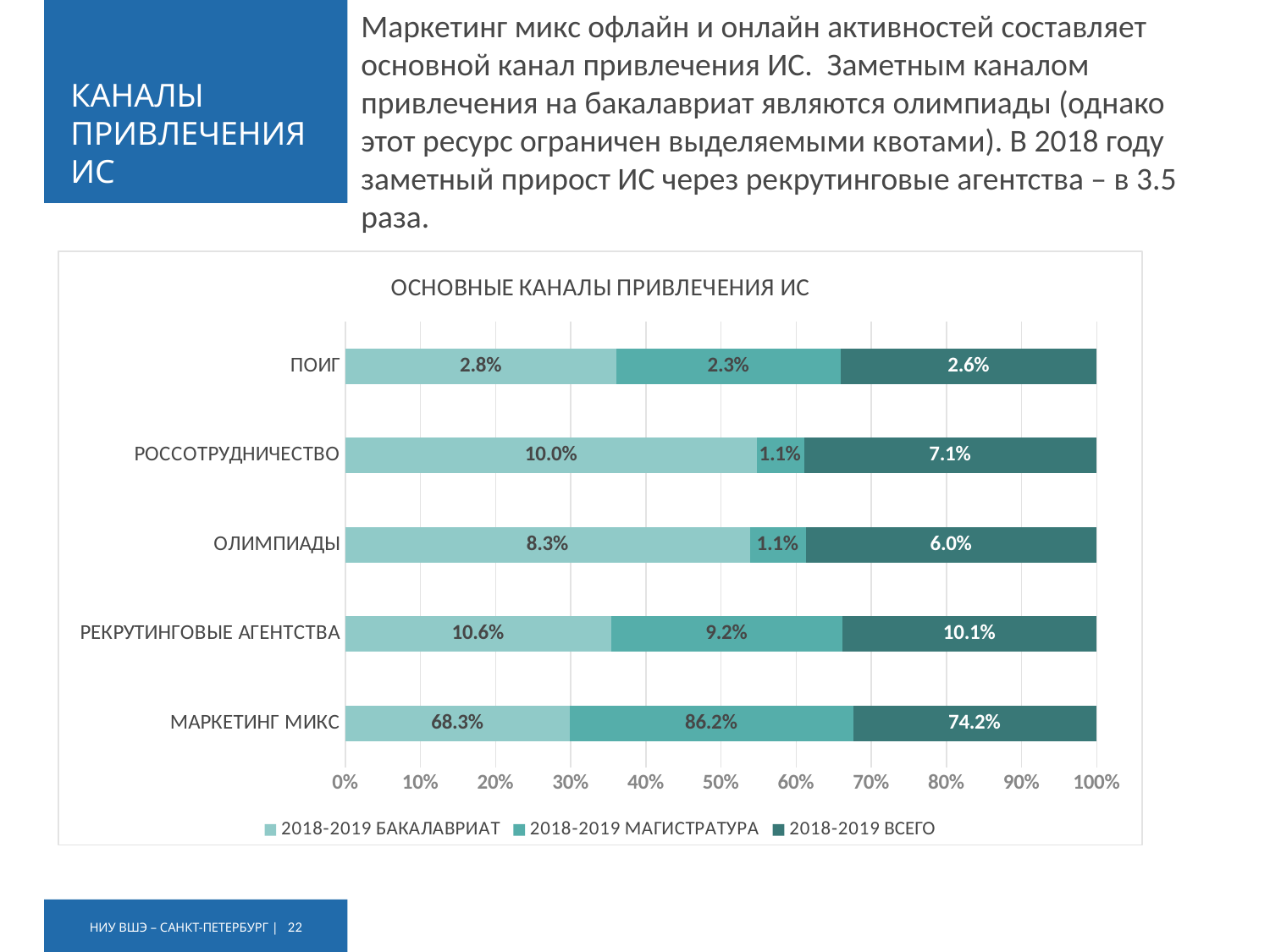
Which category has the highest value in the 2018-2019 ВСЕГО series? МАРКЕТИНГ МИКС What is the value for ПОИГ in the 2018-2019 МАГИСТРАТУРА series? 2.3% What is the value for РЕКРУТИНГОВЫЕ АГЕНТСТВА in the 2018-2019 ВСЕГО series? 10.1% What is the title of the chart? ОСНОВНЫЕ КАНАЛЫ ПРИВЛЕЧЕНИЯ ИС What is the value for ОЛИМПИАДЫ in the 2018-2019 БАКАЛАВРИАТ series? 8.3% What is the value for МАРКЕТИНГ МИКС in the 2018-2019 МАГИСТРАТУРА series? 86.2% What is the difference between the 2018-2019 МАГИСТРАТУРА and 2018-2019 БАКАЛАВРИАТ values for МАРКЕТИНГ МИКС? 17.9% How many series does the legend list? 3 Which is larger for РОССОТРУДНИЧЕСТВО: the 2018-2019 БАКАЛАВРИАТ value or the 2018-2019 ВСЕГО value? 2018-2019 БАКАЛАВРИАТ How many categories are shown on the chart? 5 What kind of chart is shown on the slide? Stacked bar chart Which category has the lowest value in the 2018-2019 БАКАЛАВРИАТ series? ПОИГ